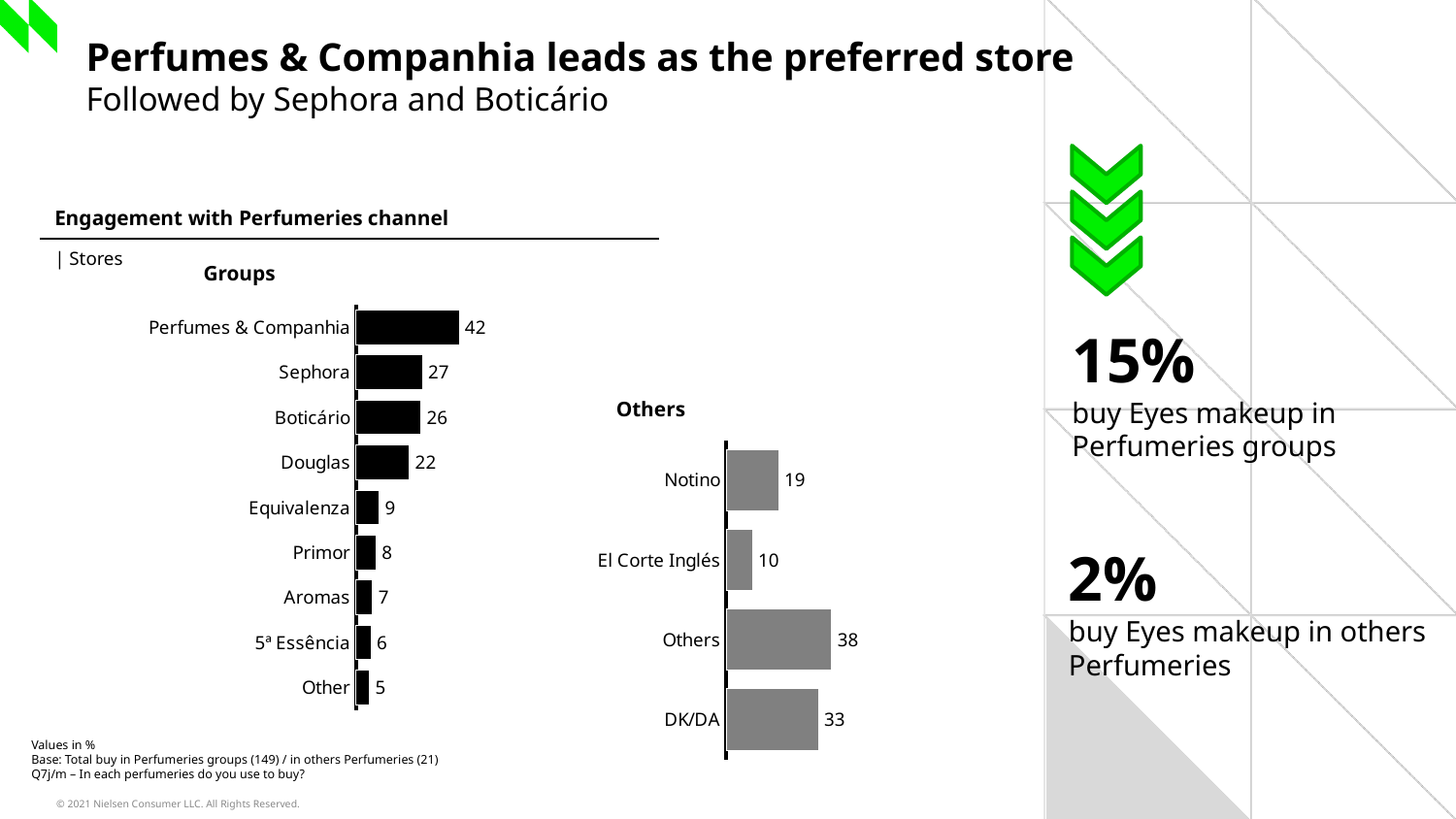
What kind of chart is the Others chart? Bar chart How many categories are shown in the Groups chart? 9 In the Groups chart, which store has the highest value? Perfumes & Companhia In the Groups chart, what is the difference between the values for Sephora and Boticário? 1 In the Groups chart, which is larger, the value for Equivalenza or the value for Primor? Equivalenza In the Groups chart, what is the value for Douglas? 22 In the Others chart, what is the value for Notino? 19 In the Others chart, what is the value for DK/DA? 33 In the Others chart, which category has the lowest value? El Corte Inglés In the Groups chart, what is the value for Perfumes & Companhia? 42 In the Groups chart, which category has the lowest value? Other In the Others chart, what is the difference between the values for Others and DK/DA? 5